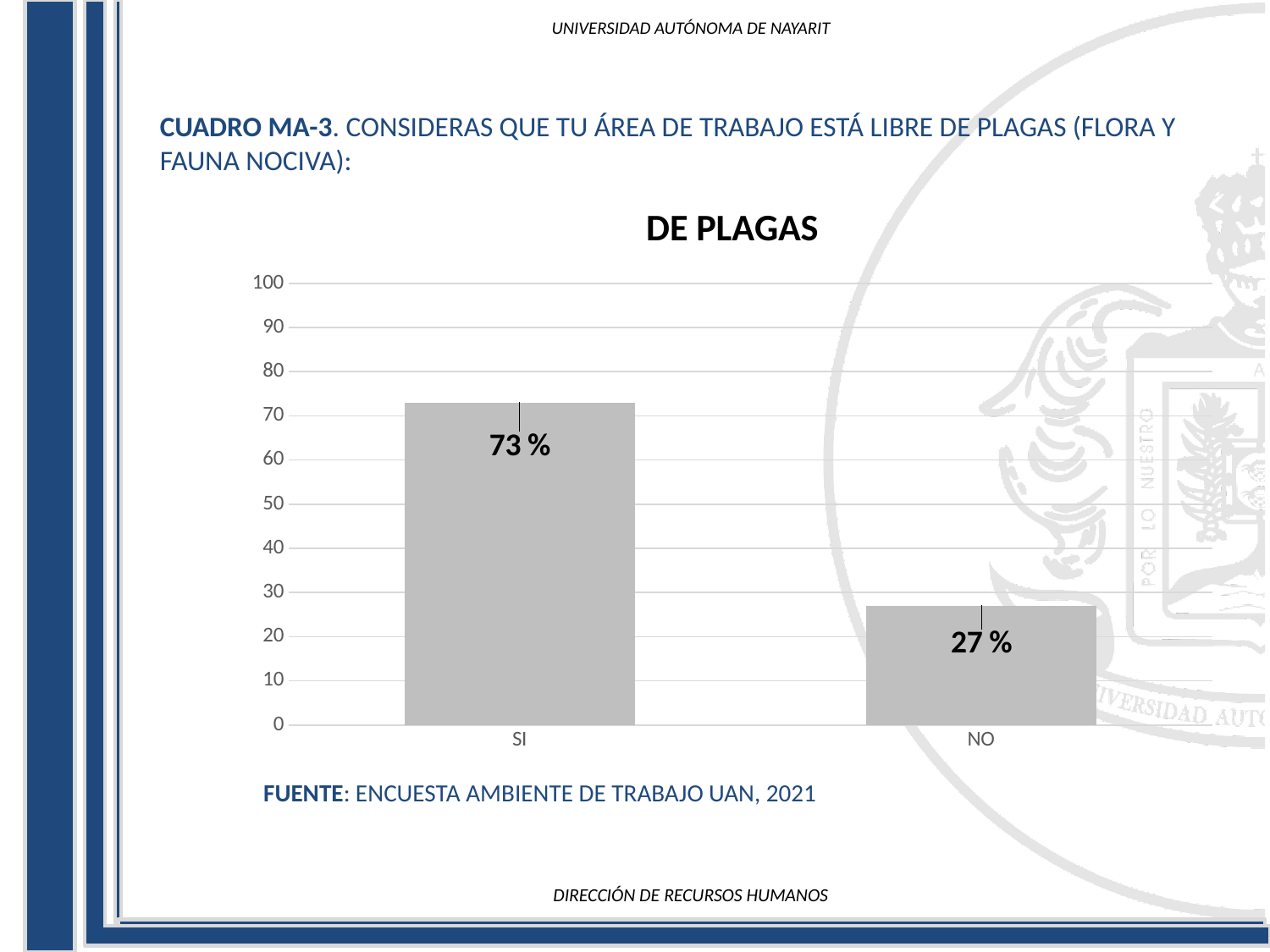
Is the value for NO greater or less than 30? less Which category has the lowest value? NO Which category has the highest value? SI What is the value for NO? 27 % What is the title of the chart? DE PLAGAS What is the difference between the values for SI and NO? 46 % Is the value for SI greater or less than 70? greater What is the value for SI? 73 % Which is larger, the value for SI or the value for NO? SI What is the highest value shown on the y axis? 100 How many categories are shown on the x axis? 2 What kind of chart is shown on the slide? bar chart